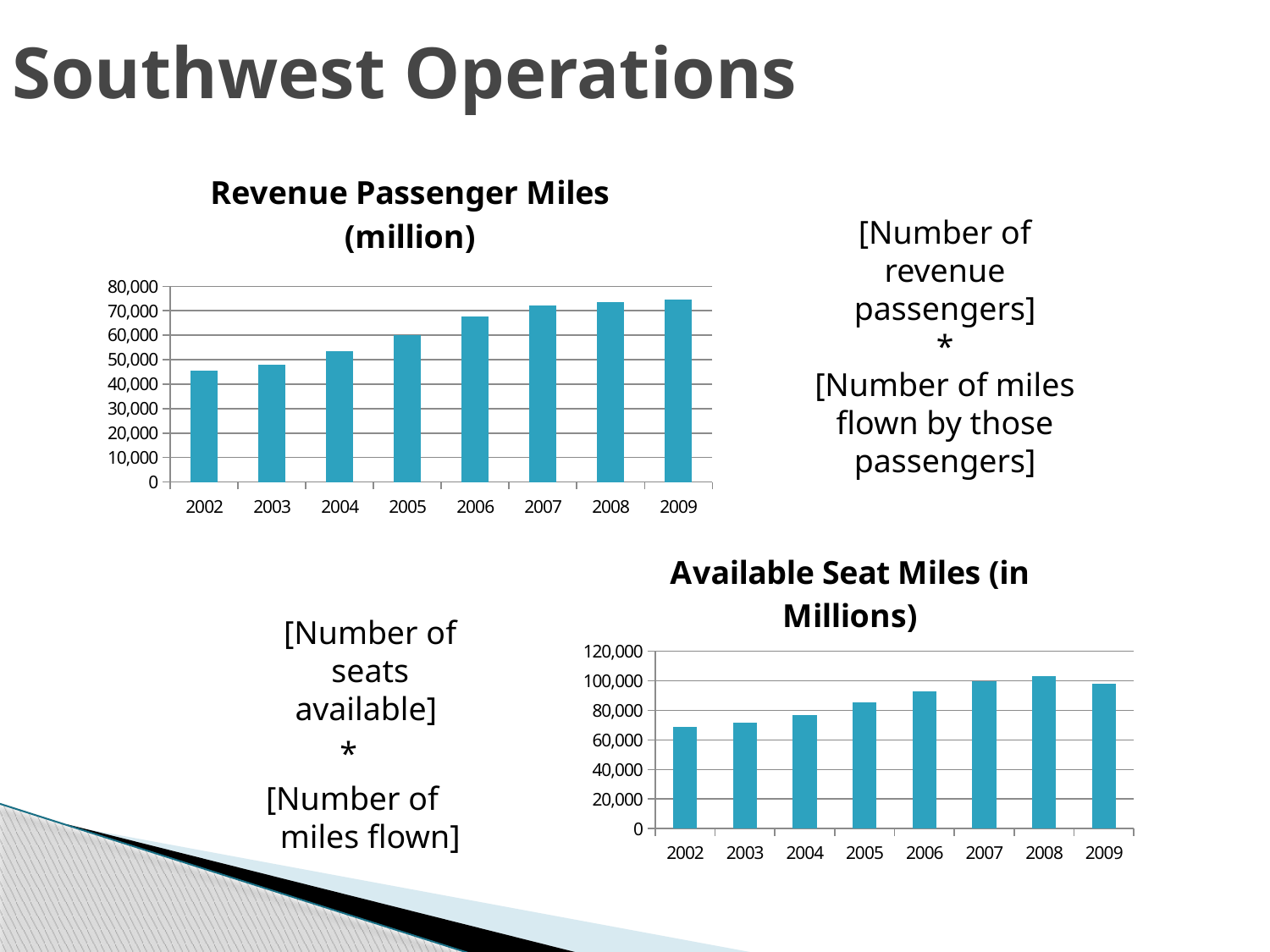
How many years are shown on the x axis of the "Available Seat Miles (in Millions)" chart? 8 In the "Available Seat Miles (in Millions)" chart, which year has the highest value? 2008 In the "Revenue Passenger Miles (million)" chart, do the values generally rise or fall from 2002 to 2009? rise In the "Revenue Passenger Miles (million)" chart, is the value for 2002 greater or less than 50,000? less In the "Available Seat Miles (in Millions)" chart, which is larger, the value for 2008 or the value for 2009? 2008 What is the title of the chart in the lower right of the slide? Available Seat Miles (in Millions) In the "Available Seat Miles (in Millions)" chart, is the value for 2008 greater or less than 100,000? greater In the "Revenue Passenger Miles (million)" chart, is the value for 2007 greater or less than 70,000? greater What type of chart is the "Revenue Passenger Miles (million)" chart? bar chart In the "Available Seat Miles (in Millions)" chart, which year has the lowest value? 2002 In the "Revenue Passenger Miles (million)" chart, which year has the lowest value? 2002